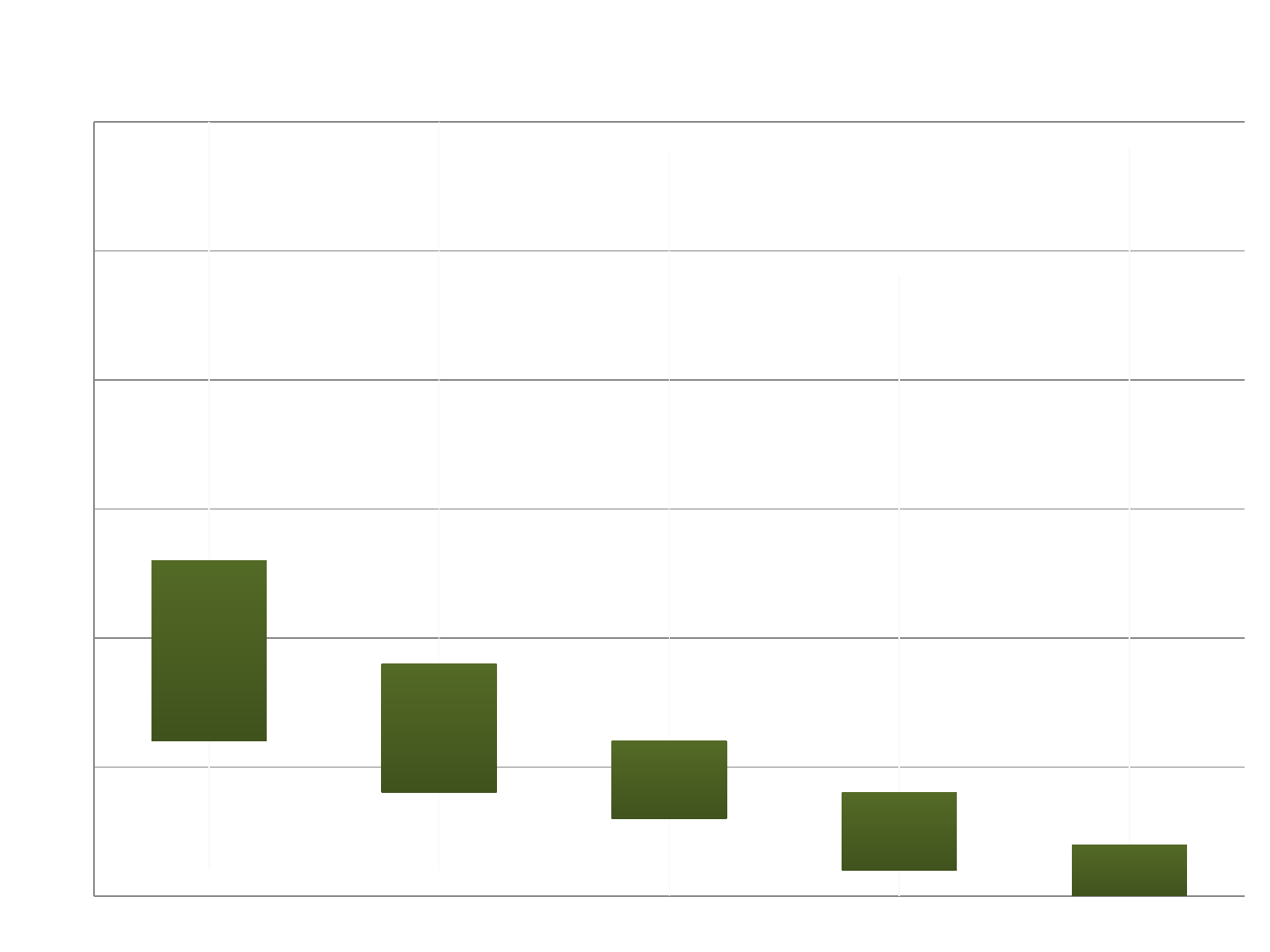
Does the chart display a legend? no Which bar reaches the highest point on the chart, the leftmost or the rightmost? leftmost Which bar is positioned lowest on the chart, the leftmost or the rightmost? rightmost What colour are the bars in the chart? green How many bars are plotted in the chart? 5 Do the bars rise or fall from left to right across the chart? fall What kind of chart is shown on the slide? bar chart